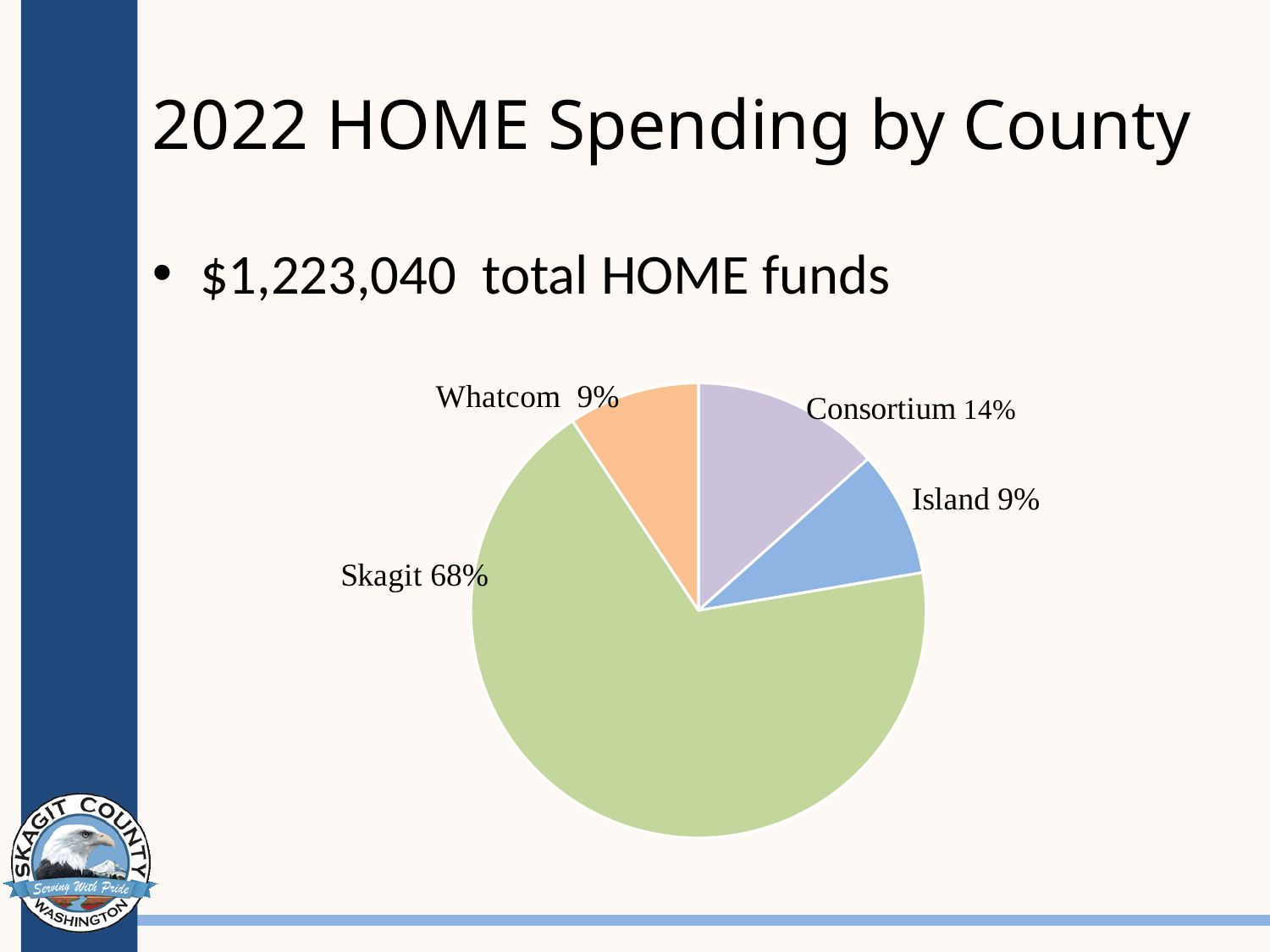
What share of 2022 HOME spending went to the Consortium? 14% What colour is the Skagit slice of the pie chart? green Which has a larger share of 2022 HOME spending, Consortium or Island? Consortium What share of 2022 HOME spending went to Island? 9% What is the difference in percentage points between the Consortium share and the Whatcom share? 5 What share of 2022 HOME spending went to Skagit? 68% What is the difference in percentage points between the Skagit share and the Consortium share? 54 What is the total amount of HOME funds stated on the slide? $1,223,040 How many slices does the pie chart have? 4 Which county has the largest share of 2022 HOME spending? Skagit What kind of chart is shown on the slide? pie chart